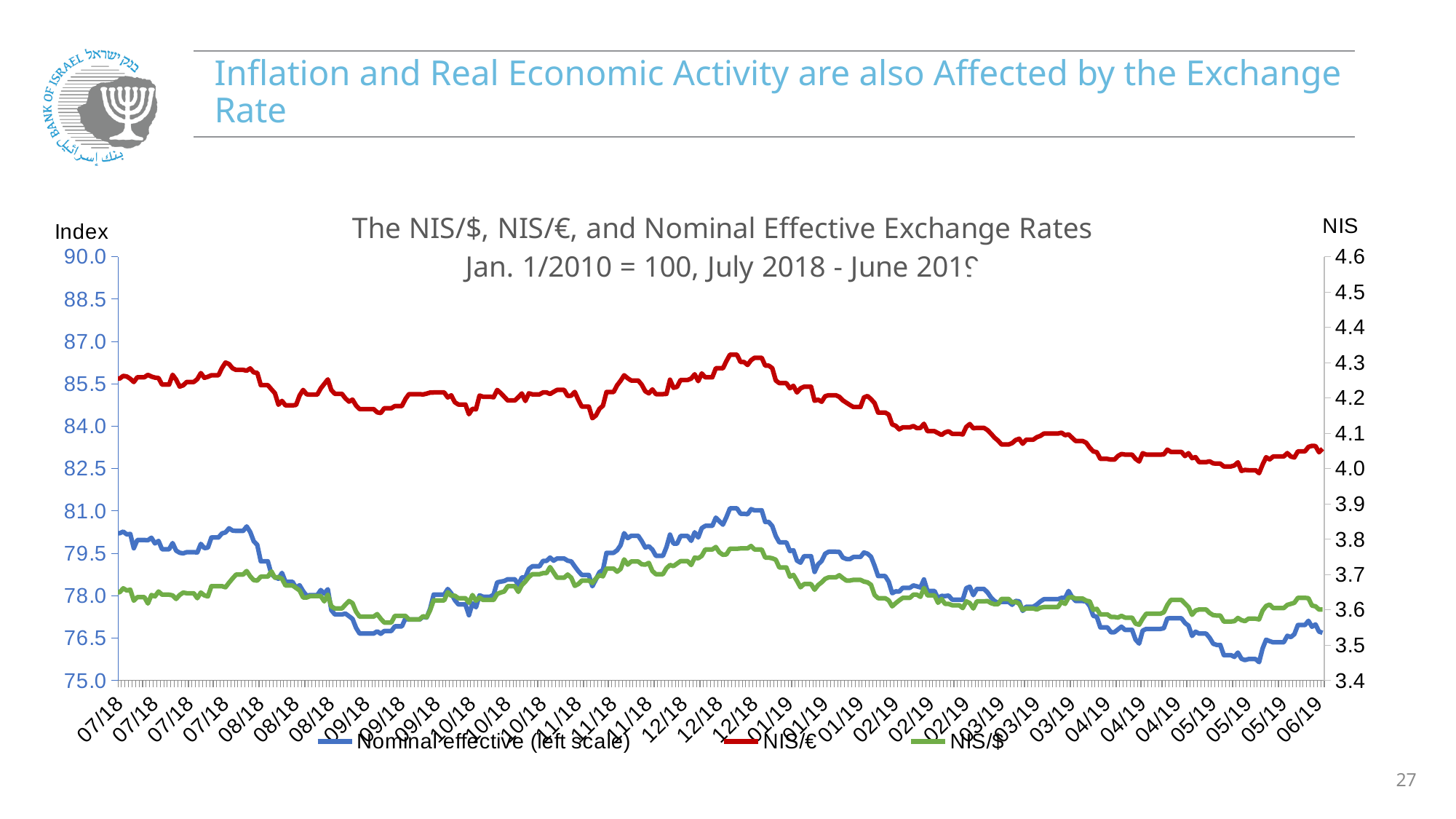
Which series has the higher values on the right-hand NIS scale throughout the period, NIS/€ or NIS/$? NIS/€ Is the NIS/$ value at the end of the period (06/19) greater or less than 3.7? less Does the NIS/€ series rise or fall overall from 07/18 to 06/19? Fall How many series does the legend list? 3 What kind of chart is shown on the slide? Line chart Is the NIS/€ value at the end of the period (06/19) greater or less than 4.1? less Does the Nominal effective series rise or fall overall from 07/18 to 06/19? Fall Is the NIS/$ value at its peak around 12/18 greater or less than 3.7? greater What is the title of the chart? The NIS/$, NIS/€, and Nominal Effective Exchange Rates Which series is plotted on the left scale according to the legend? Nominal effective